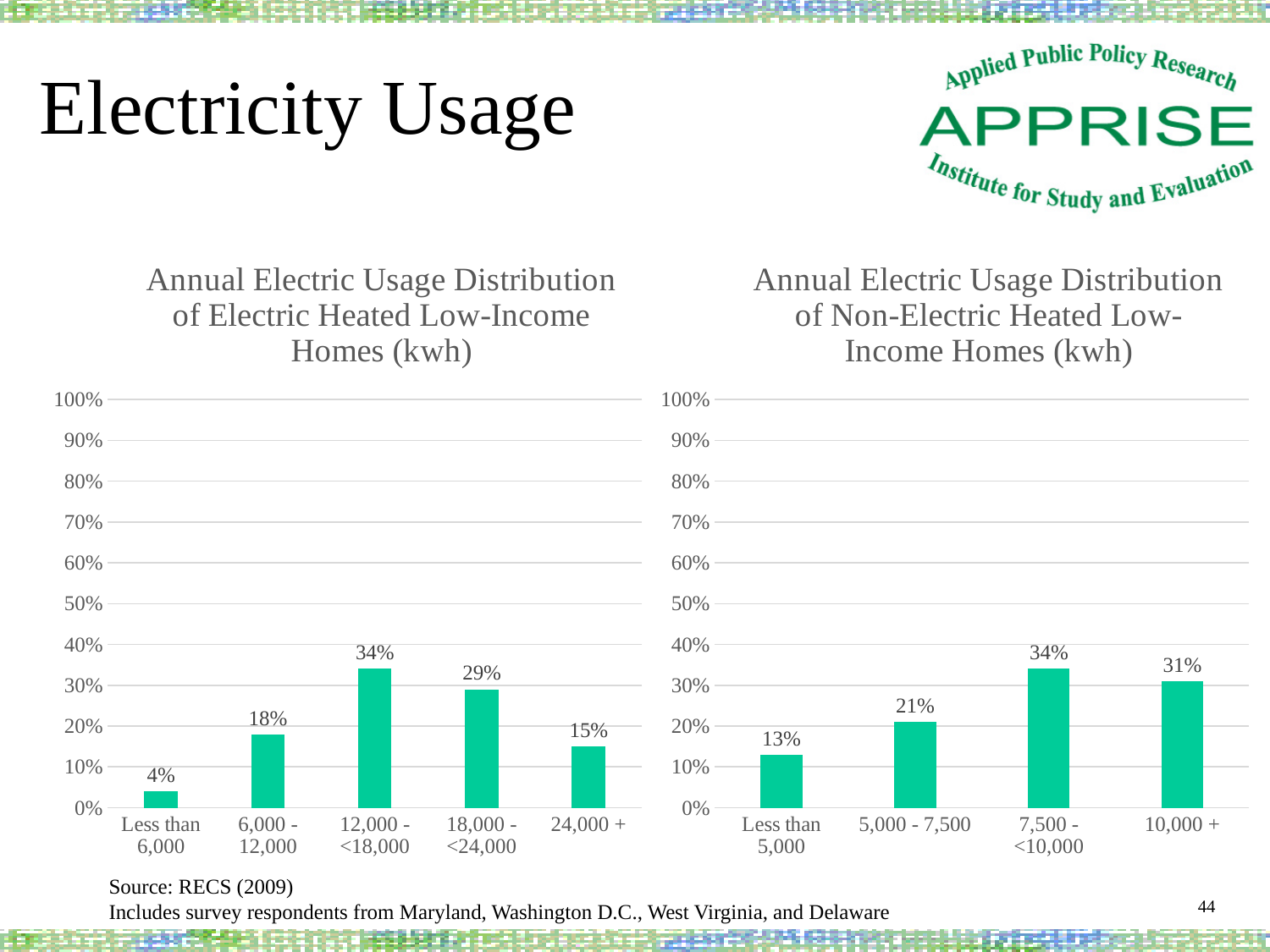
In the left chart (Electric Heated Low-Income Homes), which usage category has the lowest percentage? Less than 6,000 In the right chart (Non-Electric Heated Low-Income Homes), is the value for Less than 5,000 greater or less than 20%? less In the left chart (Electric Heated Low-Income Homes), what percentage of homes use 12,000 - <18,000 kwh? 34% In the right chart (Non-Electric Heated Low-Income Homes), what is the difference between the 5,000 - 7,500 and Less than 5,000 categories? 8% In the left chart (Electric Heated Low-Income Homes), which is larger: the 6,000 - 12,000 category or the 24,000 + category? 6,000 - 12,000 How many usage categories are shown in the left chart (Electric Heated Low-Income Homes)? 5 How many usage categories are shown in the right chart (Non-Electric Heated Low-Income Homes)? 4 In the right chart (Non-Electric Heated Low-Income Homes), which usage category has the highest percentage? 7,500 - <10,000 In the left chart (Electric Heated Low-Income Homes), what is the difference between the 18,000 - <24,000 and 24,000 + categories? 14% In the right chart (Non-Electric Heated Low-Income Homes), do the values rise or fall from Less than 5,000 to 7,500 - <10,000? Rise In the right chart (Non-Electric Heated Low-Income Homes), what percentage of homes use 10,000 + kwh? 31% What type of chart is used for the Annual Electric Usage Distribution of Electric Heated Low-Income Homes? Bar chart